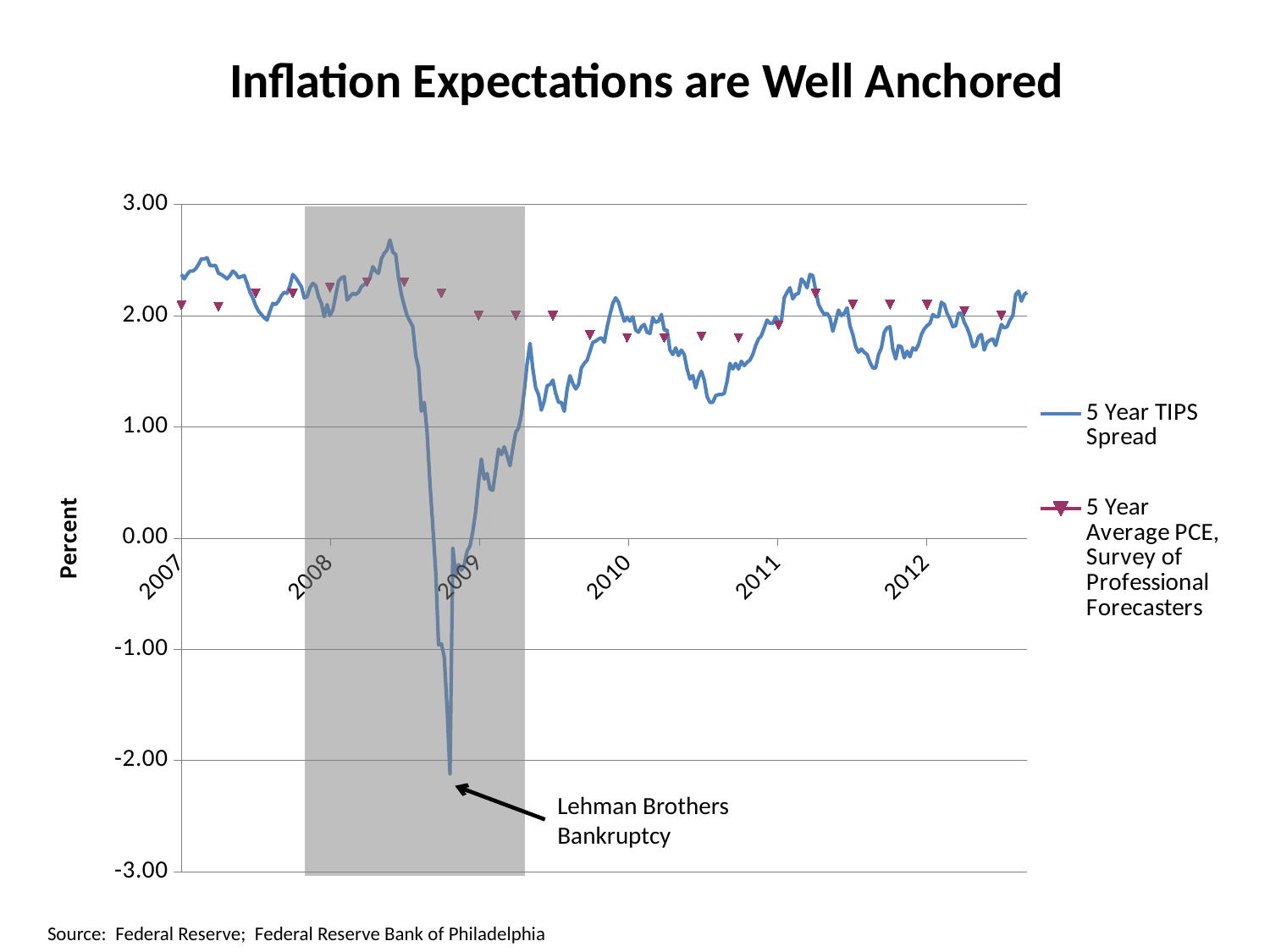
What is the label on the vertical axis? Percent Is the 5 Year TIPS Spread at the start of 2007 greater or less than 2.00? greater Does the 5 Year TIPS Spread rise or fall between early 2008 and the Lehman Brothers Bankruptcy point? fall What kind of chart is shown on the slide? line chart How many year labels are shown on the x axis? 6 Is the lowest value of the 5 Year TIPS Spread greater or less than -1.00? less Are the 5 Year Average PCE, Survey of Professional Forecasters values in 2010 greater or less than 1.00? greater How many series does the legend list? 2 Which series reaches the lowest value on the chart? 5 Year TIPS Spread What is the title of the chart? Inflation Expectations are Well Anchored Which event is annotated at the sharp dip in the 5 Year TIPS Spread? Lehman Brothers Bankruptcy